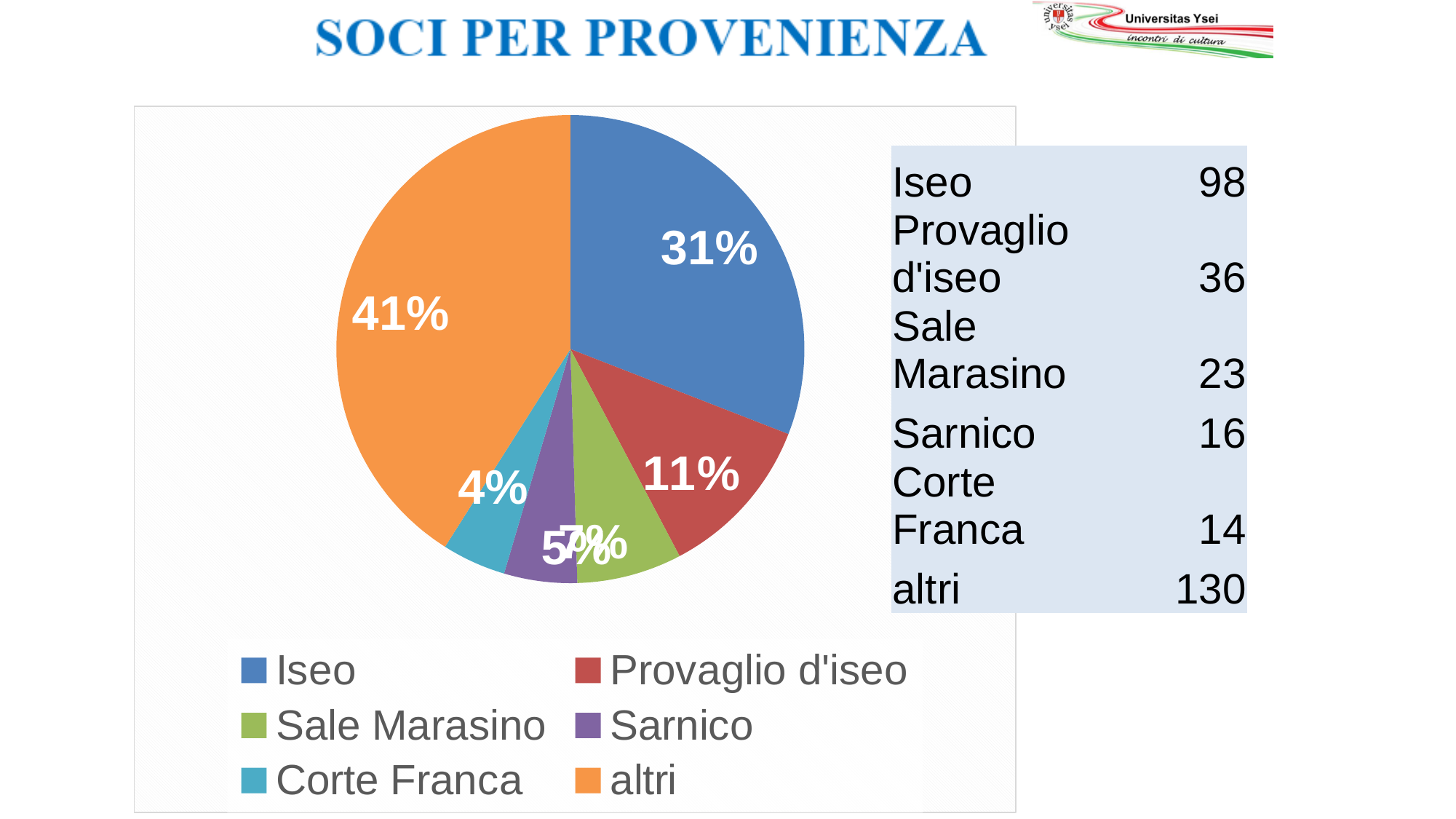
What colour is the altri slice in the pie chart? orange Which category has the largest slice of the pie? altri What percentage of the pie does the Iseo slice represent? 31% Which category has the smallest slice of the pie? Corte Franca Which slice is larger, Iseo or Provaglio d'iseo? Iseo What kind of chart is shown on the slide? pie chart What percentage of the pie does the Corte Franca slice represent? 4% According to the table next to the chart, how many members come from Sale Marasino? 23 What percentage of the pie does the Provaglio d'iseo slice represent? 11% How many categories does the pie chart have? 6 What is the difference in percentage points between the altri slice and the Iseo slice? 10%